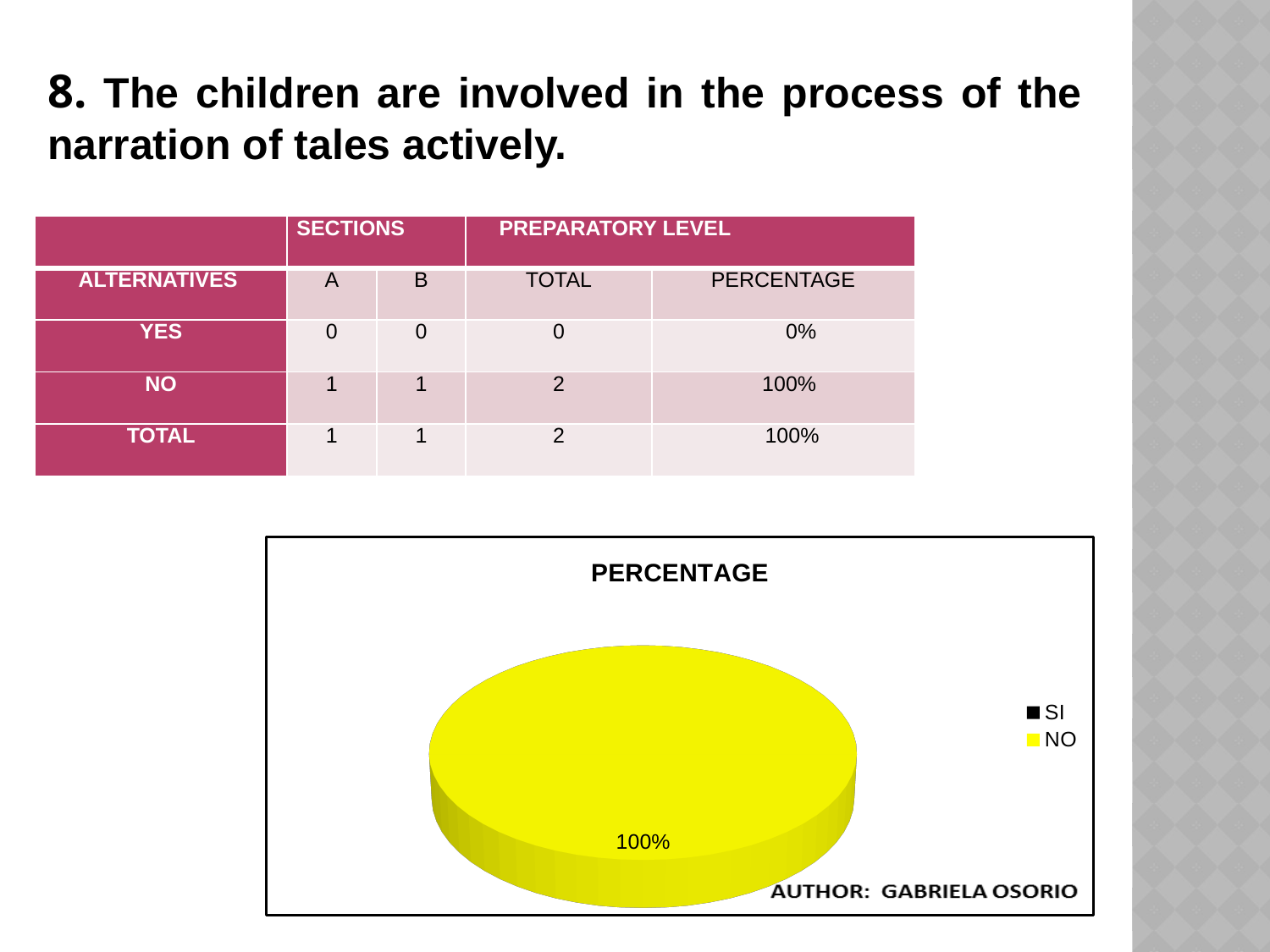
What share of the pie does the NO slice take up? 100% What is the title of the chart? PERCENTAGE Which is larger in the pie chart, the SI slice or the NO slice? NO How many entries does the chart legend list? 2 Which category has the largest slice in the pie chart? NO What percentage is shown on the NO slice of the pie chart? 100% Which legend entry is shown in yellow? NO Is the value for NO greater or less than 50%? greater What kind of chart is shown on the slide? pie chart